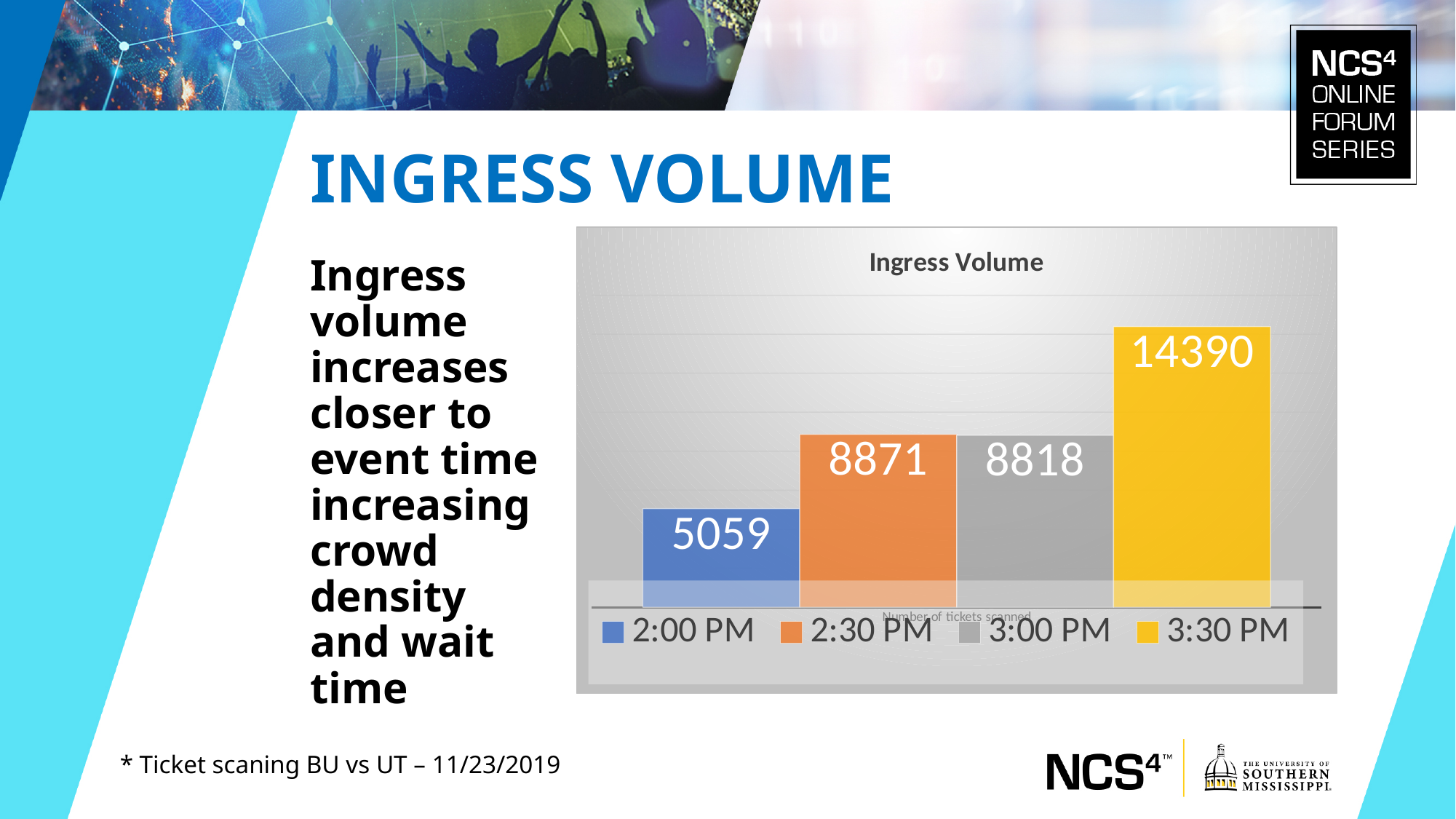
What is the ingress volume at 2:00 PM? 5059 Which time slot has the highest ingress volume? 3:30 PM What is the difference in ingress volume between 2:30 PM and 2:00 PM? 3812 How many time slots are shown in the chart? 4 What is the difference in ingress volume between 3:30 PM and 2:30 PM? 5519 What is the ingress volume at 3:30 PM? 14390 How many entries does the chart legend list? 4 What is the ingress volume at 3:00 PM? 8818 What kind of chart is shown on the slide? Bar chart Which time slot has the lowest ingress volume? 2:00 PM Which has the larger ingress volume, 2:30 PM or 3:00 PM? 2:30 PM What is the title of the chart? Ingress Volume